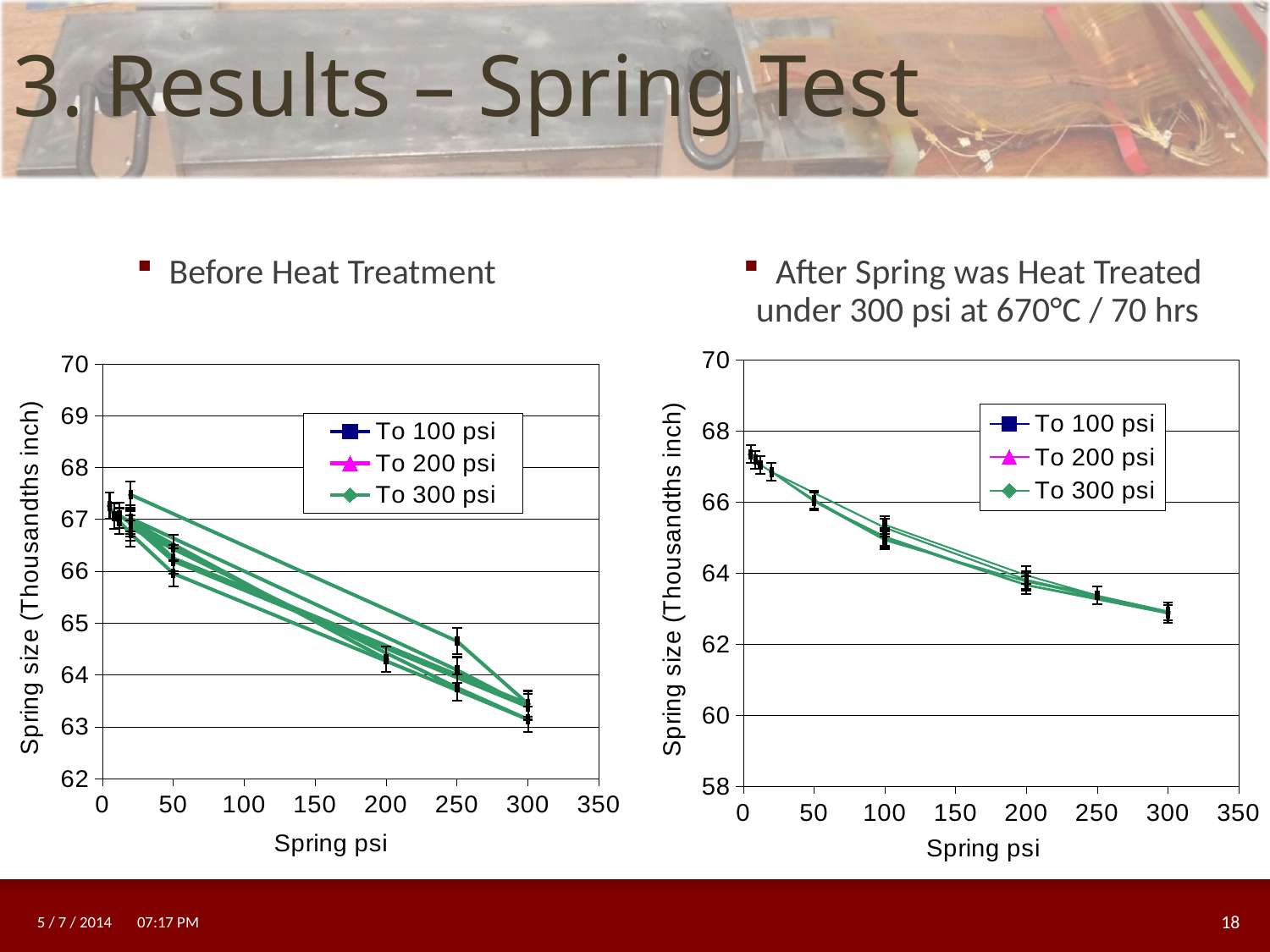
How many series does the legend of the 'Before Heat Treatment' chart list? 3 In the 'Before Heat Treatment' chart, is the spring size at 50 psi greater or less than 67? less In the chart for the spring heat treated under 300 psi at 670°C / 70 hrs, is the spring size at 250 psi greater or less than 64? less In the 'Before Heat Treatment' chart, is the spring size at 200 psi greater or less than 65? less What is the y-axis title of the 'Before Heat Treatment' chart? Spring size (Thousandths inch) What are the legend entries of the chart for the spring heat treated under 300 psi at 670°C / 70 hrs? To 100 psi, To 200 psi, To 300 psi In the 'Before Heat Treatment' chart, do the spring size values rise or fall as spring psi increases? Fall In the chart for the spring heat treated under 300 psi at 670°C / 70 hrs, do the values rise or fall as spring psi increases? Fall What kind of chart is the 'Before Heat Treatment' chart on the left? Line chart